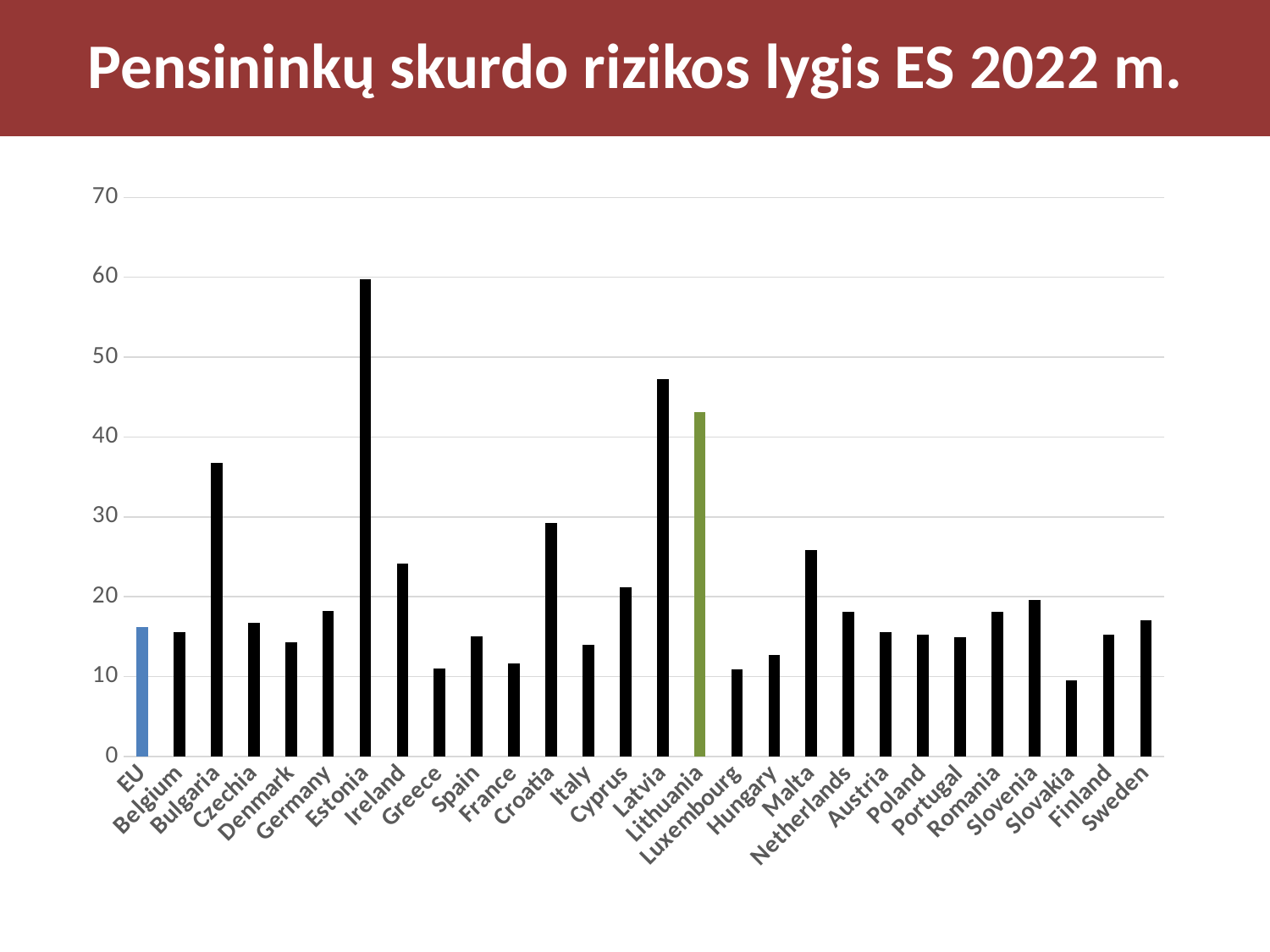
Which category has the lowest value? Slovakia How many categories are plotted on the x axis? 28 What kind of chart is shown on the slide? bar chart Is the value for Latvia greater or less than 50? less Is the value for Italy greater or less than 20? less Which category has the highest value? Estonia Is the value for Bulgaria greater or less than 30? greater What colour is the bar for Lithuania? green Which is larger, the value for Latvia or the value for Lithuania? Latvia Which is larger, the value for Bulgaria or the value for Croatia? Bulgaria